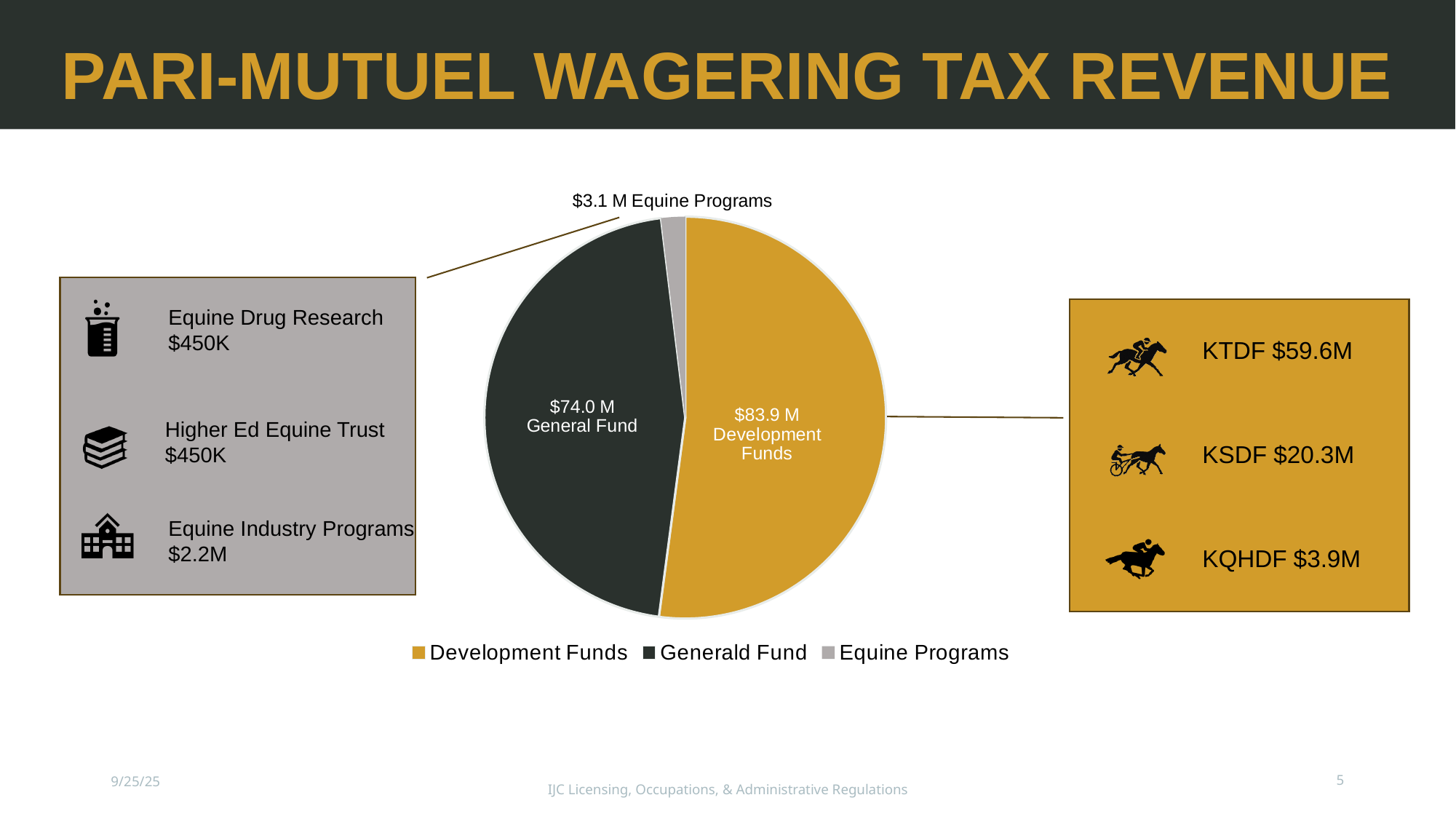
Which slice of the pie chart is the smallest? Equine Programs What type of chart is shown on the slide? pie chart Which slice of the pie chart is the largest? Development Funds What is the difference between the Development Funds and General Fund values? $9.9 M What is the value of the Equine Programs slice? $3.1 M How many entries does the legend list? 3 What is the value of the General Fund slice? $74.0 M How many slices does the pie chart have? 3 Which is larger, the General Fund slice or the Equine Programs slice? General Fund What colour is the Development Funds slice? gold What is the total of all three slices in the pie chart? $161.0 M What is the value of the Development Funds slice? $83.9 M